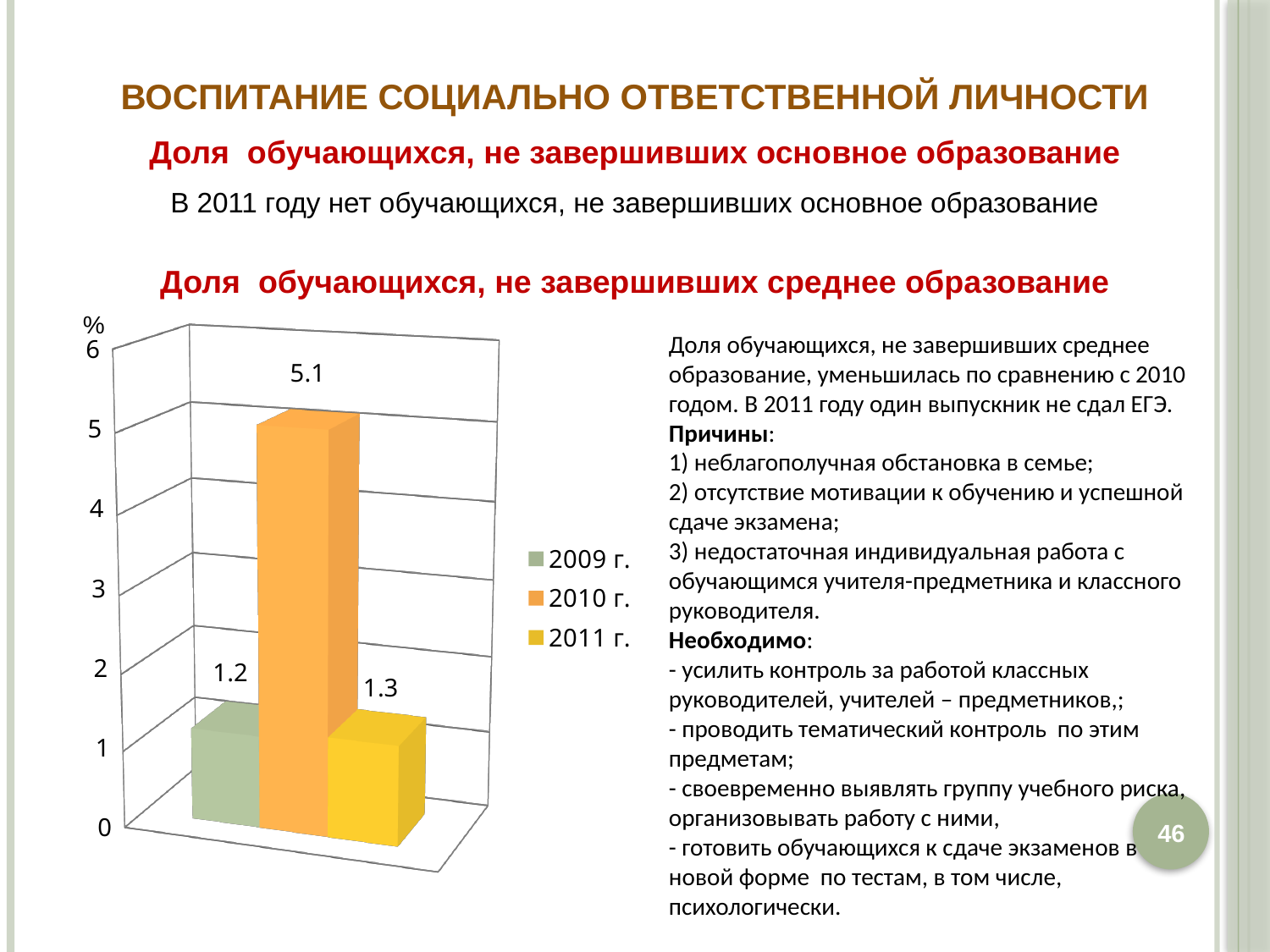
What is the value for 2009 г. in the chart? 1.2 Is the value for 2010 г. greater or less than 4? greater Which year has the highest value in the chart? 2010 г. What is the value for 2011 г. in the chart? 1.3 What is the difference between the values for 2010 г. and 2011 г.? 3.8 What is the difference between the values for 2011 г. and 2009 г.? 0.1 Which is larger, the value for 2010 г. or the value for 2009 г.? 2010 г. What kind of chart is shown on the slide? Bar chart What is the value for 2010 г. in the chart? 5.1 Which year has the lowest value in the chart? 2009 г. What is the title of the chart? Доля обучающихся, не завершивших среднее образование How many series does the legend list? 3